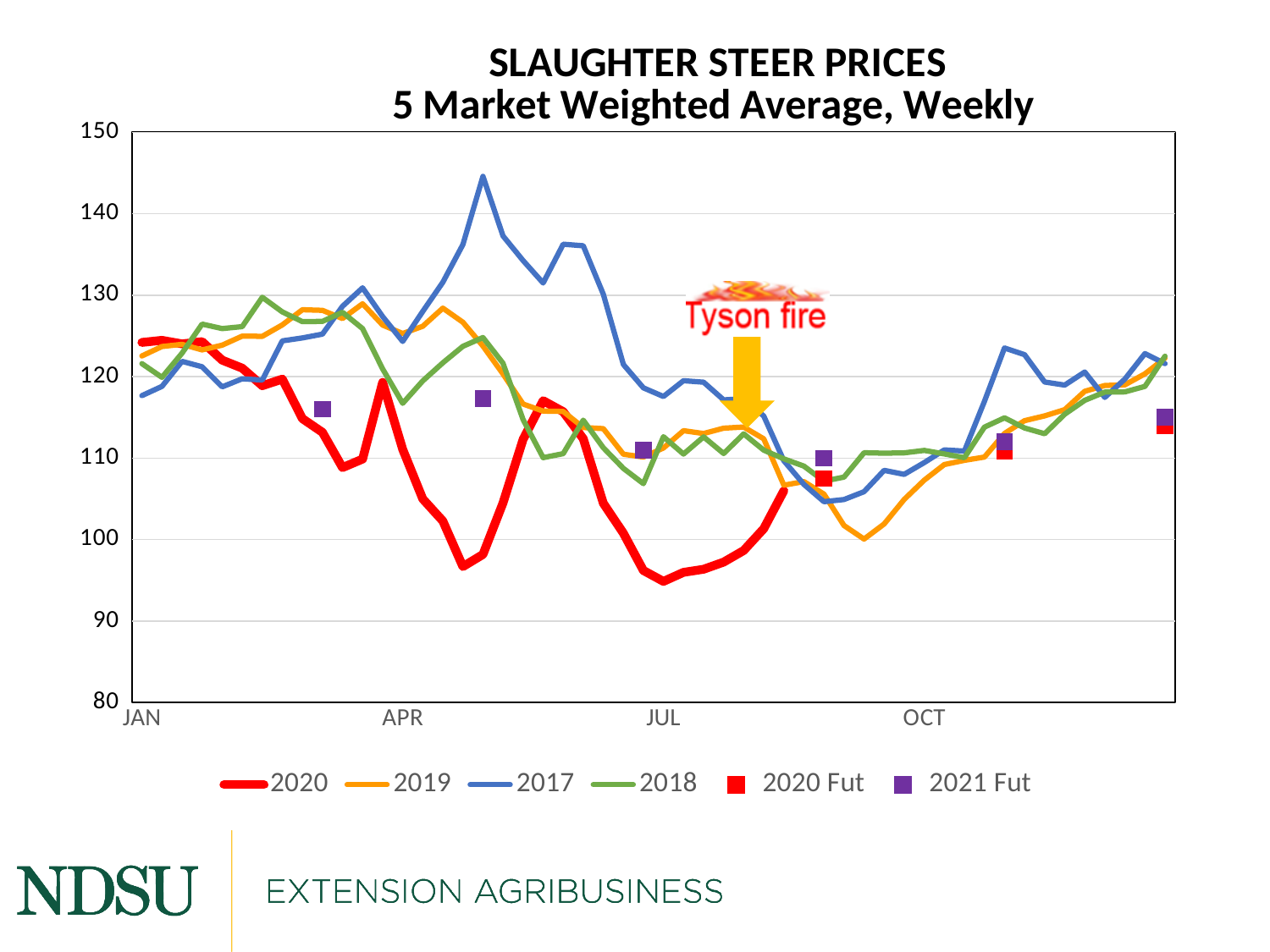
Which series reaches the highest value anywhere on the chart? 2017 How many series does the legend list? 6 At the start of January, is the 2020 line higher or lower than the 2017 line? higher Is the last 2021 Fut marker, near the right edge of the chart, greater or less than 110? greater How many month labels are shown on the x axis? 4 Is the lowest point of the 2020 line greater or less than 100? less Does the 2020 line rise or fall from January to early March? fall What kind of chart is shown on the slide? line chart Which series reaches the lowest value anywhere on the chart? 2020 What event does the yellow arrow annotation on the chart mark? Tyson fire Is the lowest point of the 2019 line, around October, greater or less than 110? less